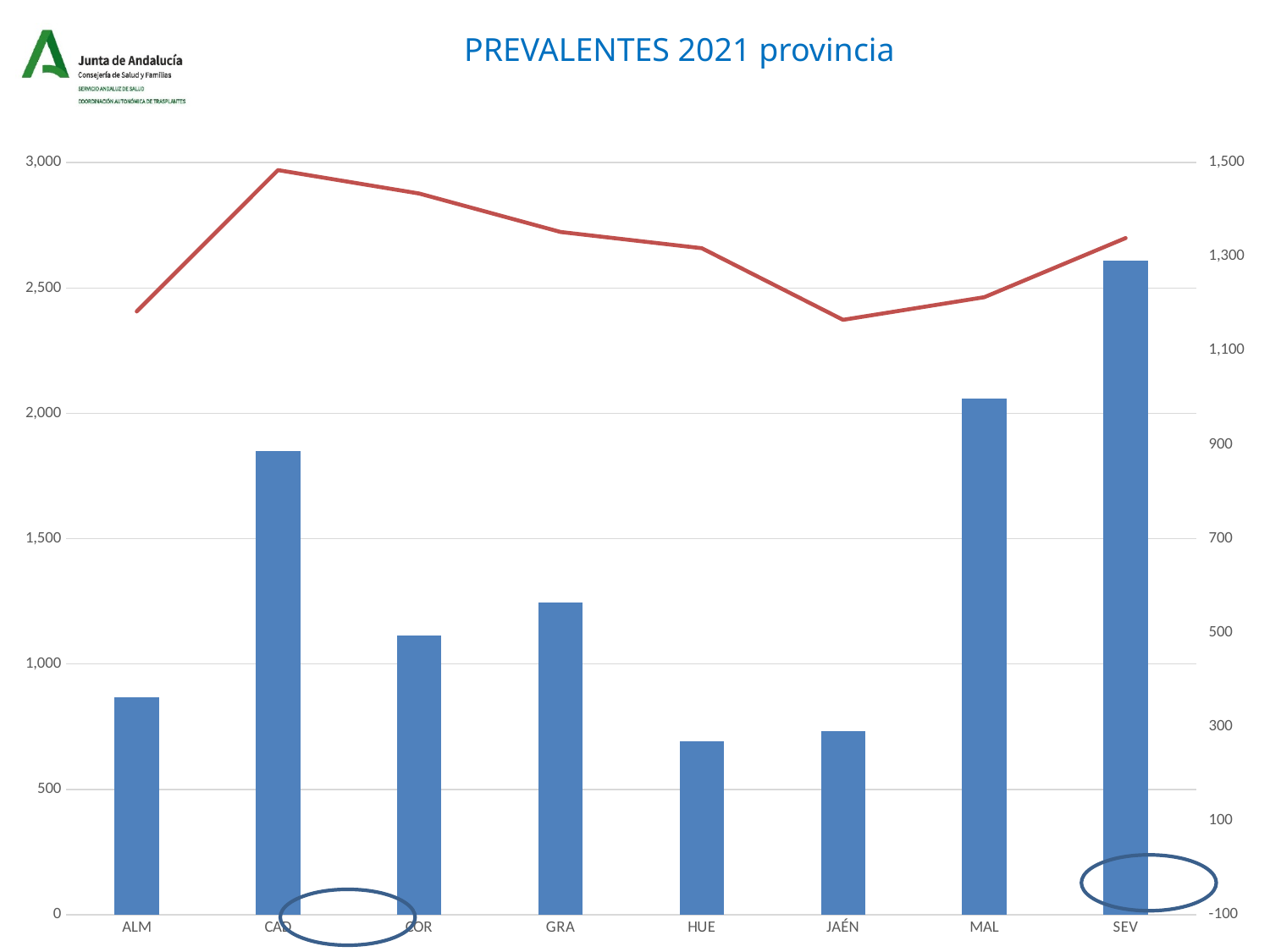
Is the bar value for MAL greater or less than 2,000 on the left axis? greater What is the title of the chart? PREVALENTES 2021 provincia What kind of chart is shown on the slide? A combined bar and line chart How many provinces are shown along the x axis? 8 At which province does the red line reach its highest point? CAD Which bar is taller, MAL or CAD? MAL Is the bar value for HUE greater or less than 1,000 on the left axis? less Is the bar value for SEV greater or less than 2,500 on the left axis? greater Which province has the tallest bar? SEV Does the red line rise or fall from CAD to JAÉN? It falls